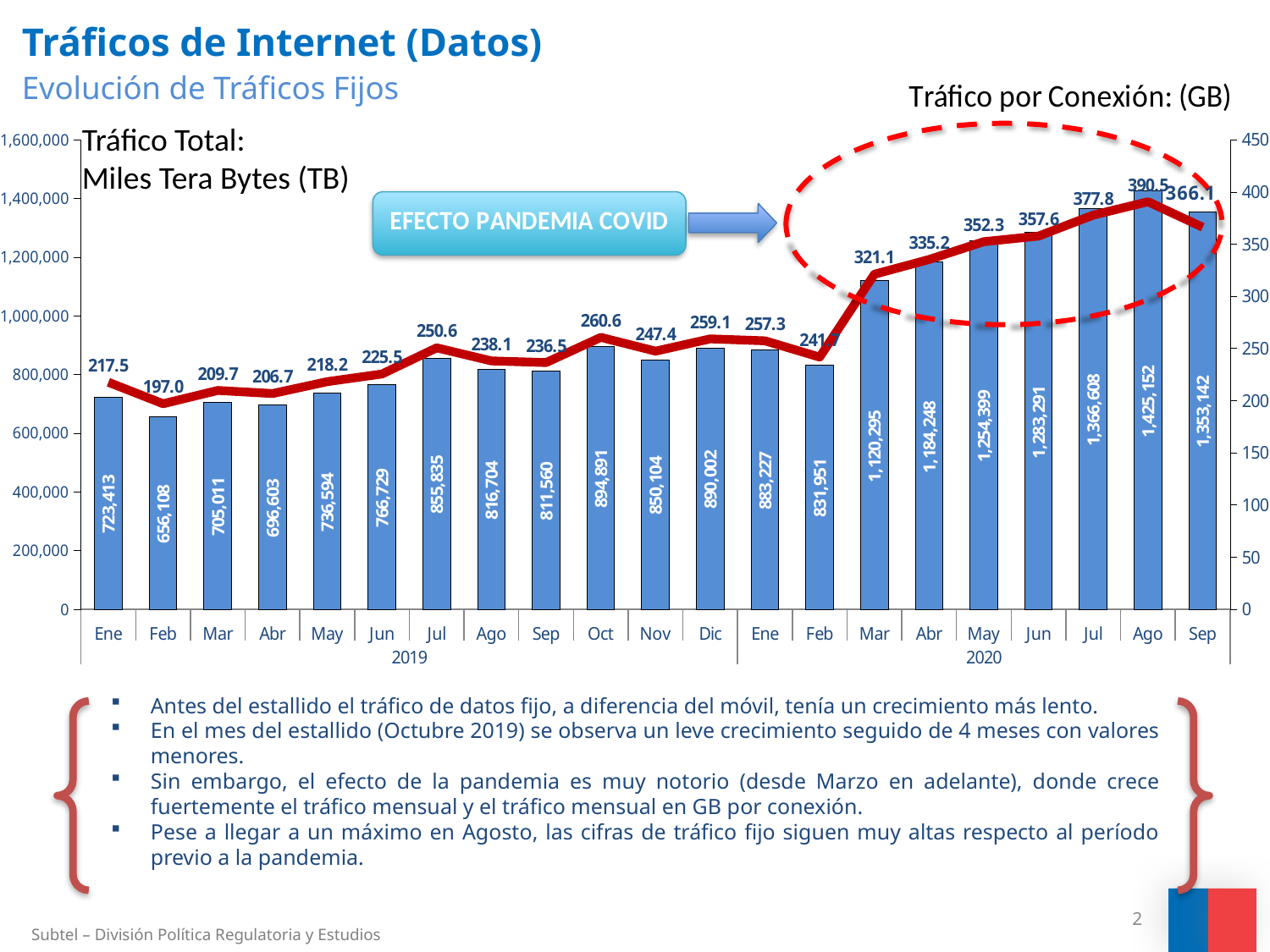
Which is larger, the bar value for Oct 2019 or for Dic 2019? Oct 2019 Do the bar values generally rise or fall from Mar 2020 to Ago 2020? rise What text is shown in the callout box pointing to the 2020 data? EFECTO PANDEMIA COVID What is the bar value for Feb 2019? 656,108 How many months (bars) are plotted in the chart? 21 Which month has the lowest total traffic bar? Feb 2019 What is the traffic per connection (GB) shown for Mar 2020? 321.1 Which month has the lowest traffic per connection value on the line? Feb 2019 What is the difference between the bar values for Ago 2020 and Sep 2020? 72,010 Which month has the highest total traffic bar? Ago 2020 What is the total fixed traffic (bar value) for Ago 2020? 1,425,152 What is the difference between the traffic per connection values for Jul 2020 and Jun 2020? 20.2